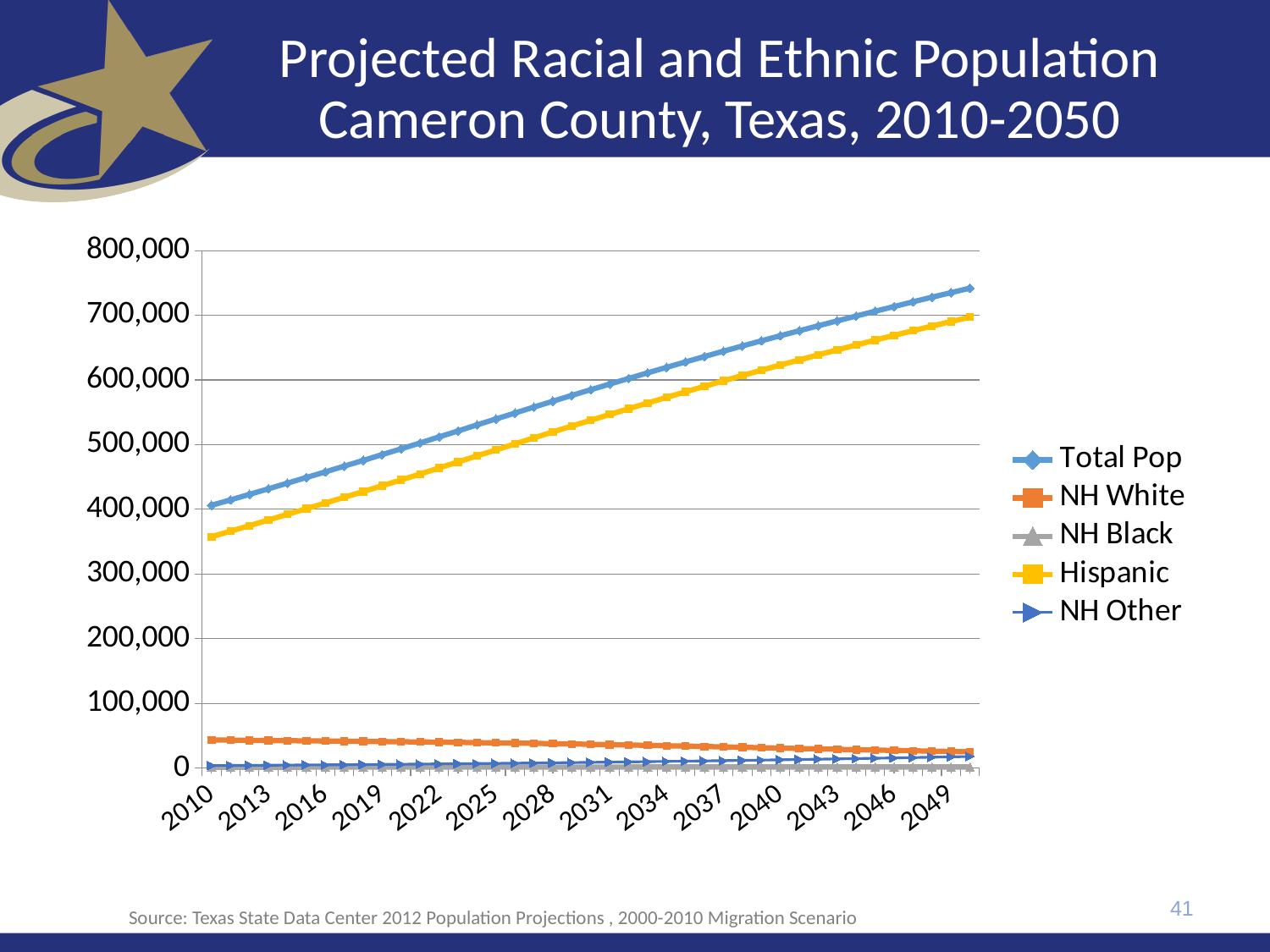
Is the value for Hispanic in 2040 greater or less than 600,000? greater Does the Total Pop series rise or fall from 2010 to 2049? rise Is the value for Hispanic in 2010 greater or less than 400,000? less Does the NH White series rise or fall from 2010 to 2049? fall What colour is the Hispanic line in the legend? yellow Which series has the highest values across the chart? Total Pop What kind of chart is shown on the slide? line chart How many series does the legend list? 5 Which is larger in 2031, NH White or Hispanic? Hispanic Does the Hispanic series rise or fall from 2010 to 2049? rise Is the value for Total Pop in 2049 greater or less than 700,000? greater